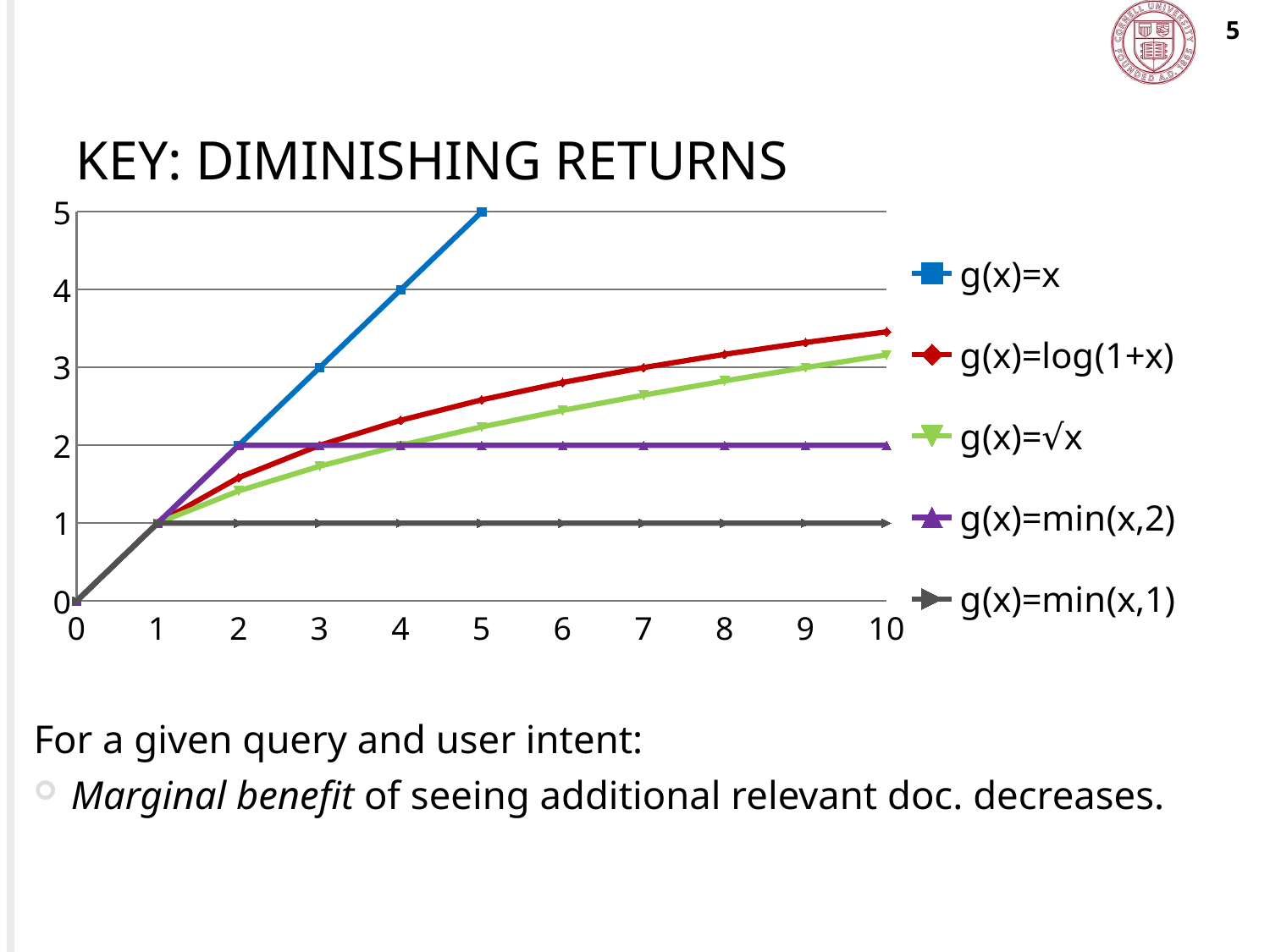
How many series does the legend list? 5 At x=10, which is larger: g(x)=log(1+x) or g(x)=√x? g(x)=log(1+x) What is the value of g(x)=min(x,1) at x=8? 1 Which series has the highest value at x=5? g(x)=x What is the value of g(x)=min(x,2) at x=10? 2 What kind of chart is shown on the slide? line chart What is the value of g(x)=x at x=3? 3 Which series has the lowest value at x=10? g(x)=min(x,1) What is the value of g(x)=x at x=5? 5 What is the title of the chart's slide? KEY: DIMINISHING RETURNS What is the value of g(x)=√x at x=4? 2 At x=10, is the value of g(x)=log(1+x) greater or less than 3? greater